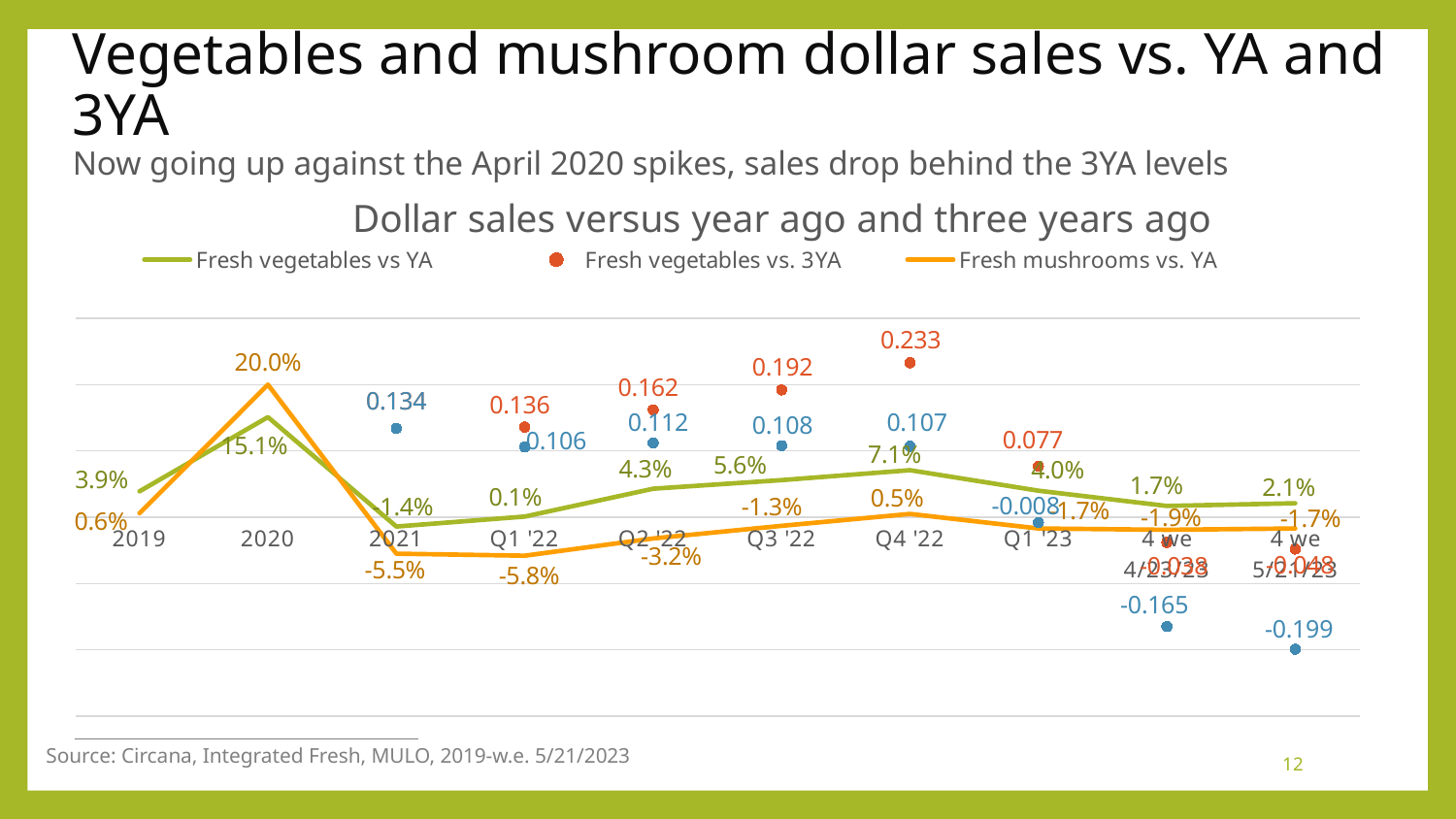
How many series does the legend list? 3 In Q4 '22, which is larger: Fresh vegetables vs YA or Fresh mushrooms vs. YA? Fresh vegetables vs YA What is the Fresh mushrooms vs. YA value for Q1 '22? -5.8% What is the Fresh mushrooms vs. YA value for 2020? 20.0% In 2020, how much higher is Fresh mushrooms vs. YA than Fresh vegetables vs YA? 4.9 percentage points In which period is Fresh mushrooms vs. YA at its highest? 2020 How many periods are shown on the x axis? 10 What is the Fresh vegetables vs YA value for 2020? 15.1% What is the Fresh vegetables vs. 3YA value for Q4 '22? 0.233 Does Fresh vegetables vs. 3YA rise or fall from Q1 '22 to Q4 '22? Rise What is the Fresh vegetables vs YA value for Q4 '22? 7.1% In which period is Fresh vegetables vs YA at its lowest? 2021